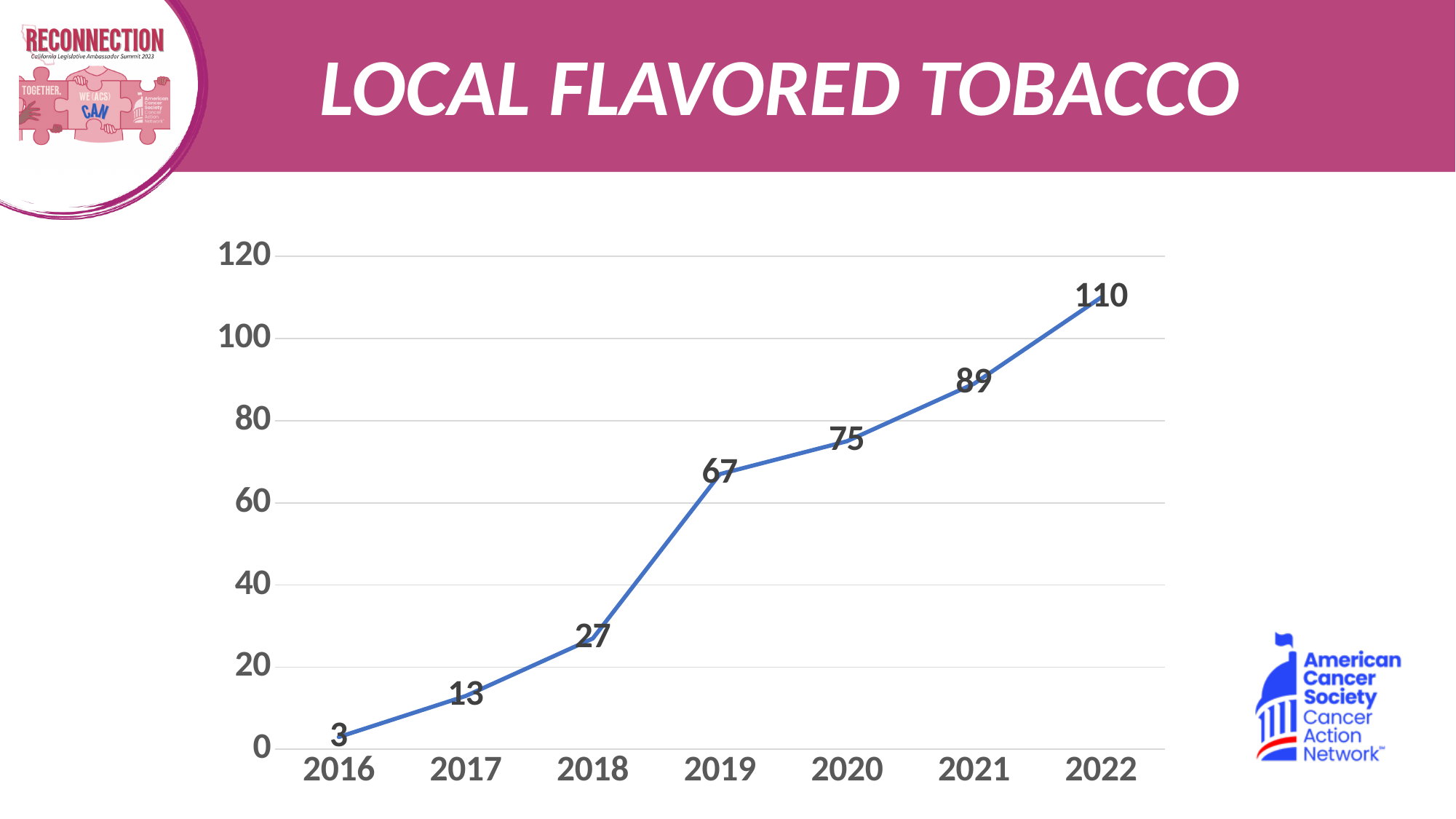
What is the value for 2019? 67 What is the difference between the values for 2022 and 2021? 21 Which is larger, the value for 2018 or the value for 2020? 2020 What kind of chart is shown on the slide? line chart Which year has the lowest value? 2016 Do the values rise or fall from 2016 to 2022? rise Which year has the highest value? 2022 What is the value for 2016? 3 What is the difference between the values for 2019 and 2018? 40 How many years are plotted on the chart? 7 What is the value for 2021? 89 Is the value for 2022 greater or less than 100? greater